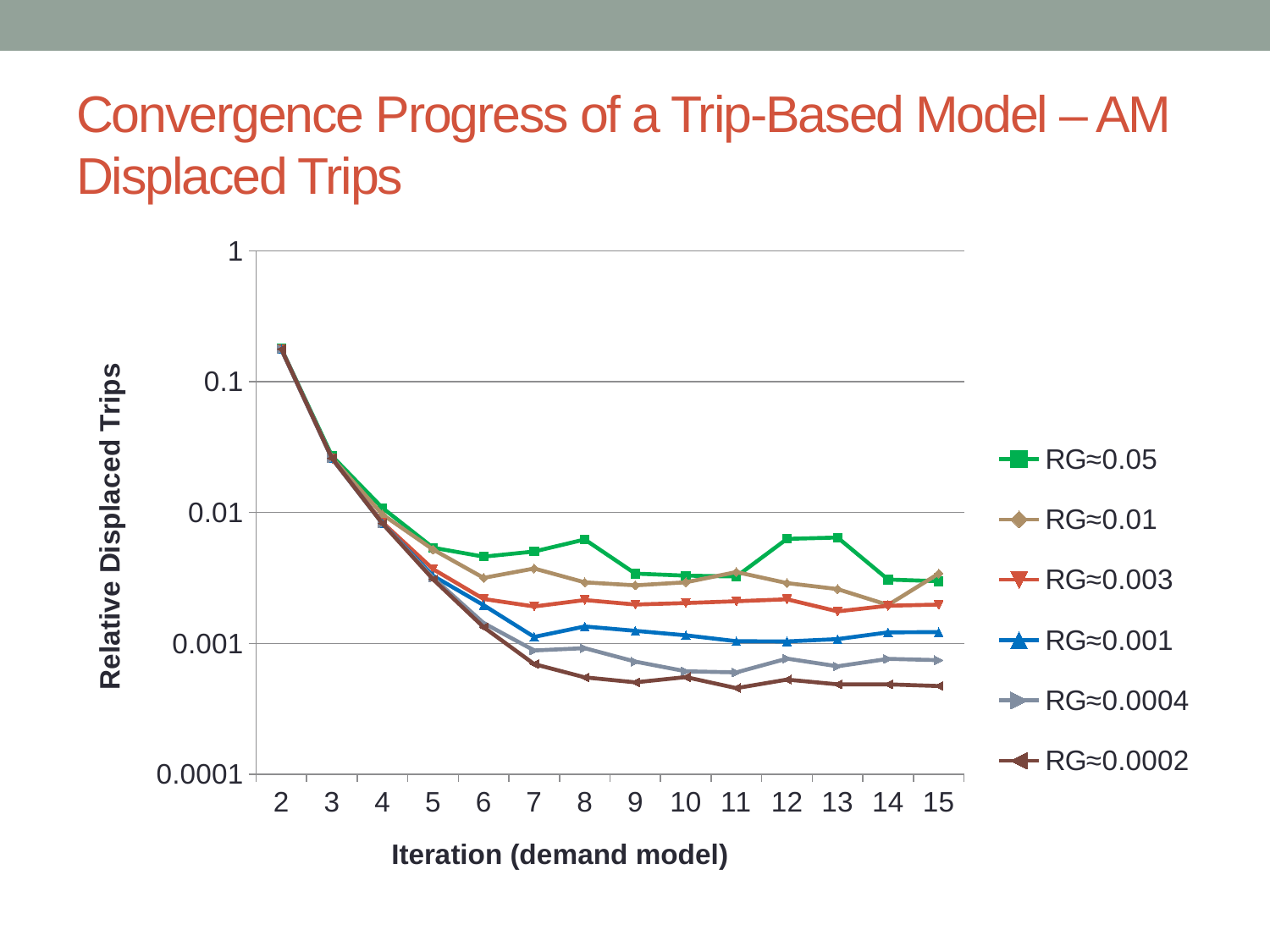
At iteration 15, which is larger: the value for RG≈0.05 or the value for RG≈0.0002? RG≈0.05 Is the value for RG≈0.05 at iteration 3 greater or less than 0.01? greater Is the value for RG≈0.0002 at iteration 15 greater or less than 0.001? less Is the value for RG≈0.001 at iteration 15 greater or less than 0.01? less Which series has the lowest value at iteration 15? RG≈0.0002 What kind of chart is shown on the slide? line chart How many series does the legend list? 6 How many iterations are plotted along the x axis? 14 Do the values for RG≈0.0002 rise or fall from iteration 2 to iteration 15? fall What is the title of the x axis? Iteration (demand model) Which series has the highest value at iteration 13? RG≈0.05